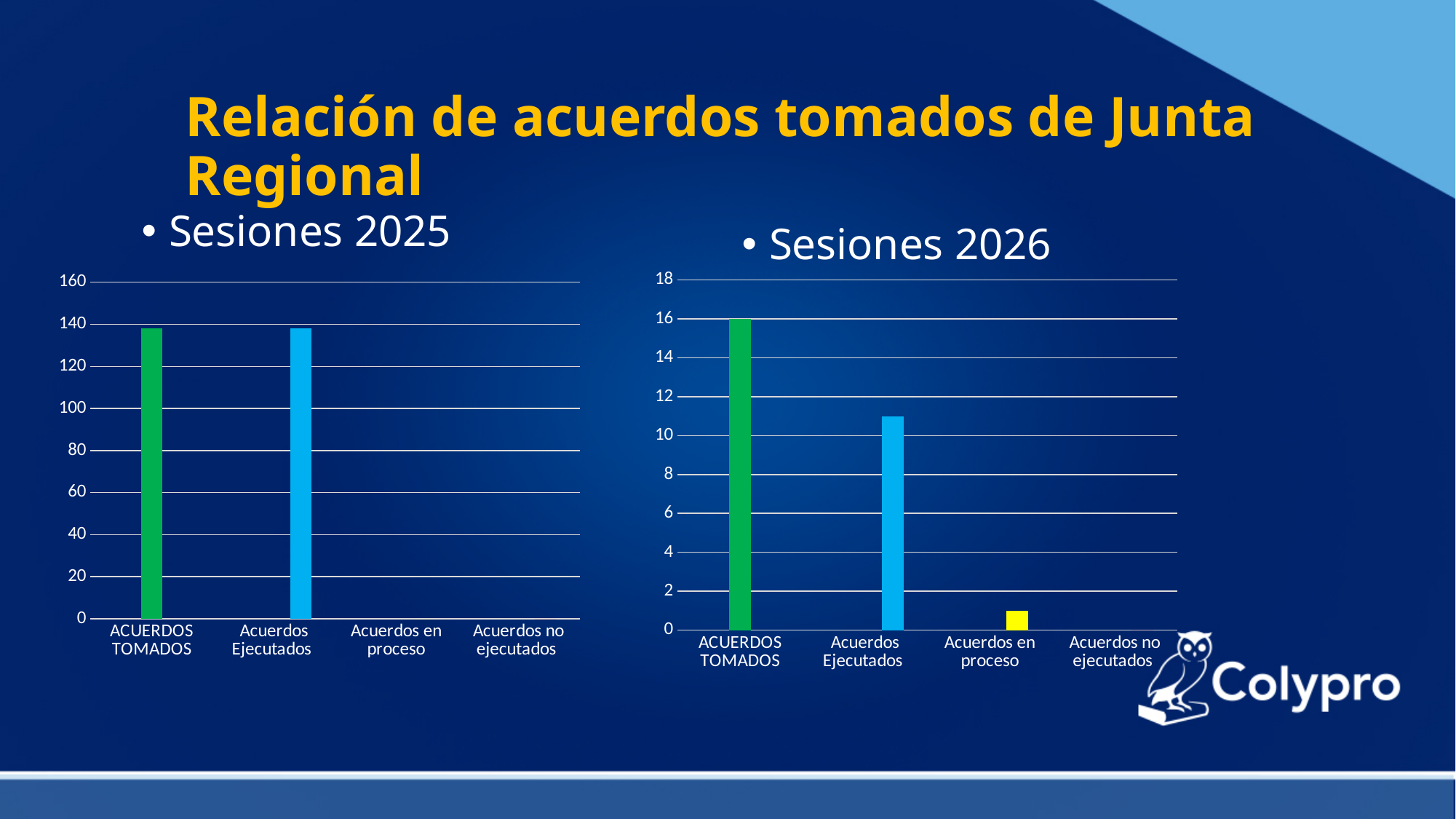
In the Sesiones 2026 chart, which is larger: Acuerdos Ejecutados or Acuerdos en proceso? Acuerdos Ejecutados In the Sesiones 2026 chart, which category has the highest value? ACUERDOS TOMADOS In the Sesiones 2025 chart, is the value for ACUERDOS TOMADOS greater or less than 120? greater How many categories are shown on the x axis of the Sesiones 2026 chart? 4 In the Sesiones 2026 chart, what is the value for ACUERDOS TOMADOS? 16 In the Sesiones 2026 chart, which category has the lowest value? Acuerdos no ejecutados In the Sesiones 2026 chart, is the value for Acuerdos en proceso greater or less than 2? less What kind of chart is the Sesiones 2025 chart? bar chart In the Sesiones 2025 chart, which is larger: ACUERDOS TOMADOS or Acuerdos en proceso? ACUERDOS TOMADOS In the Sesiones 2026 chart, is the value for Acuerdos Ejecutados greater or less than 10? greater In the Sesiones 2026 chart, what colour is the bar for Acuerdos en proceso? yellow